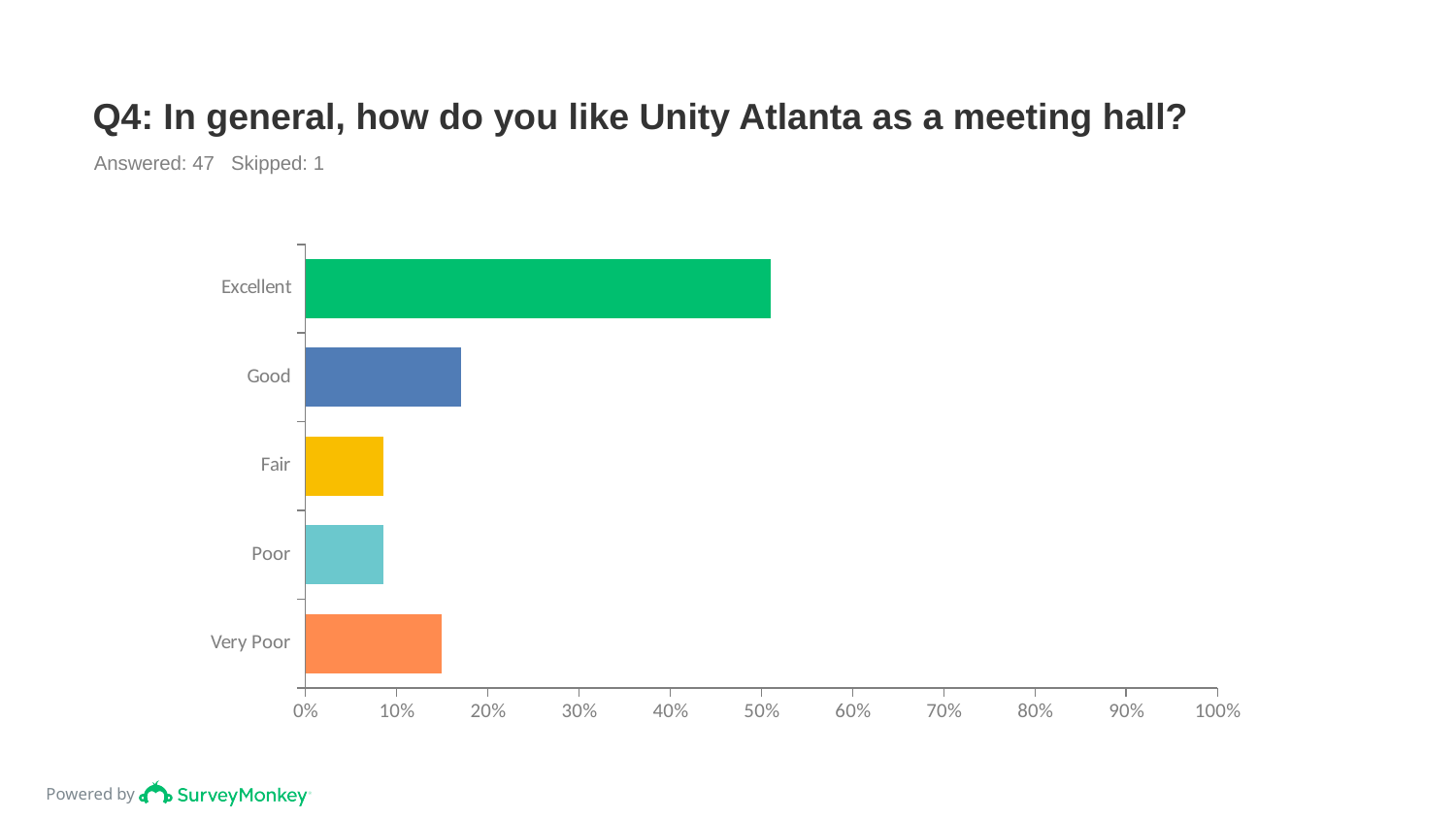
Which is larger, the value for Excellent or the value for Good? Excellent Is the value for Good greater or less than 20%? less Is the value for Excellent greater or less than 40%? greater Which is larger, the value for Very Poor or the value for Fair? Very Poor What is the title of the chart? Q4: In general, how do you like Unity Atlanta as a meeting hall? What is the highest value shown on the horizontal axis? 100% How many response categories are shown on the chart? 5 Is the value for Poor greater or less than 20%? less What kind of chart is shown on the slide? Bar chart Which response category has the highest percentage? Excellent